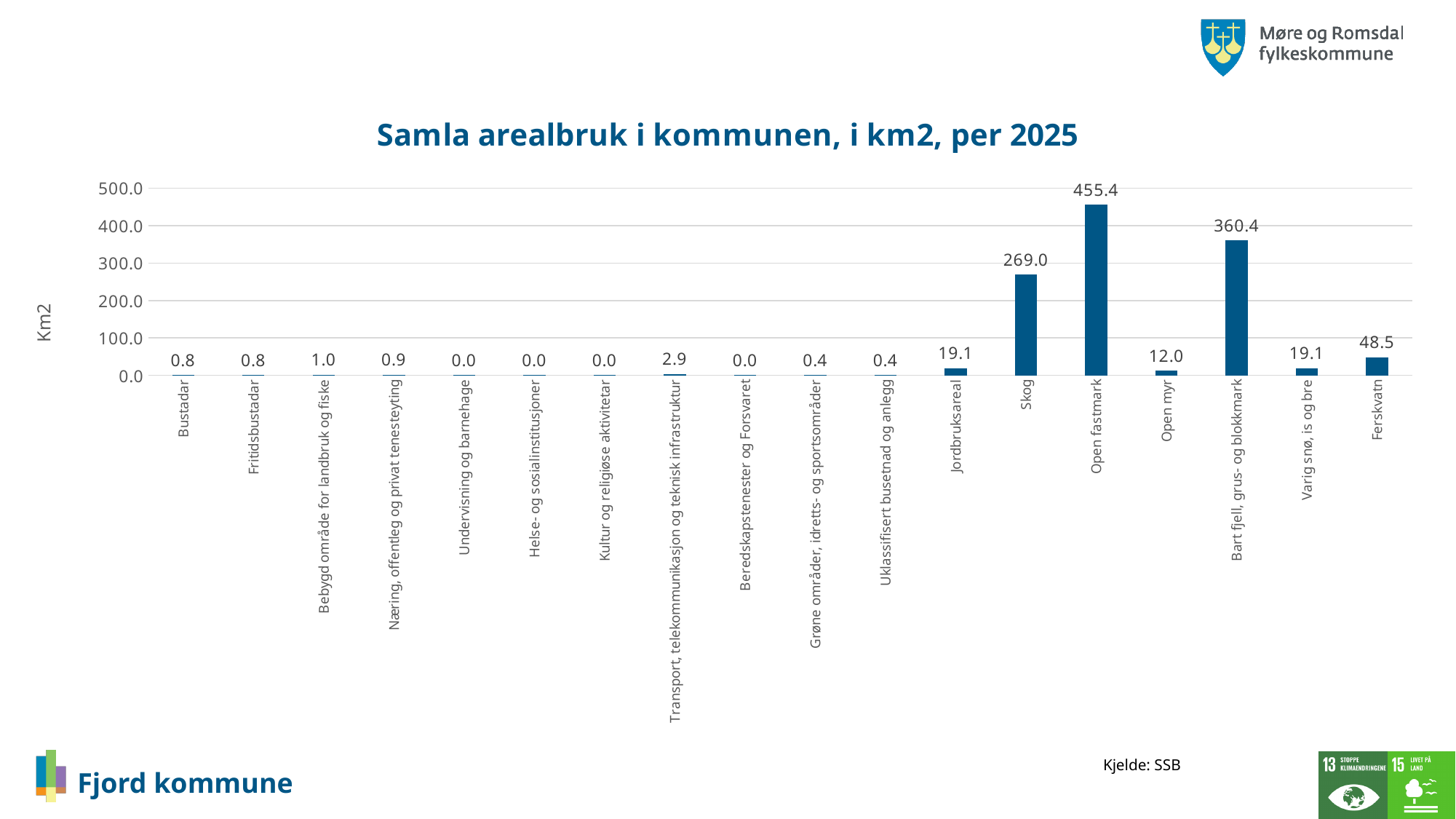
What is the value for Skog? 269.0 Which is larger, the value for Skog or the value for Bart fjell, grus- og blokkmark? Bart fjell, grus- og blokkmark What is the value for Transport, telekommunikasjon og teknisk infrastruktur? 2.9 Which category has the highest value? Open fastmark What is the difference between the values for Skog and Ferskvatn? 220.5 What is the value for Open fastmark? 455.4 How many categories are shown on the x axis? 18 What kind of chart is shown on the slide? Bar chart What is the difference between the values for Open fastmark and Bart fjell, grus- og blokkmark? 95.0 What is the title of the chart? Samla arealbruk i kommunen, i km2, per 2025 What is the value for Ferskvatn? 48.5 How many categories have a value of 0.0? 4